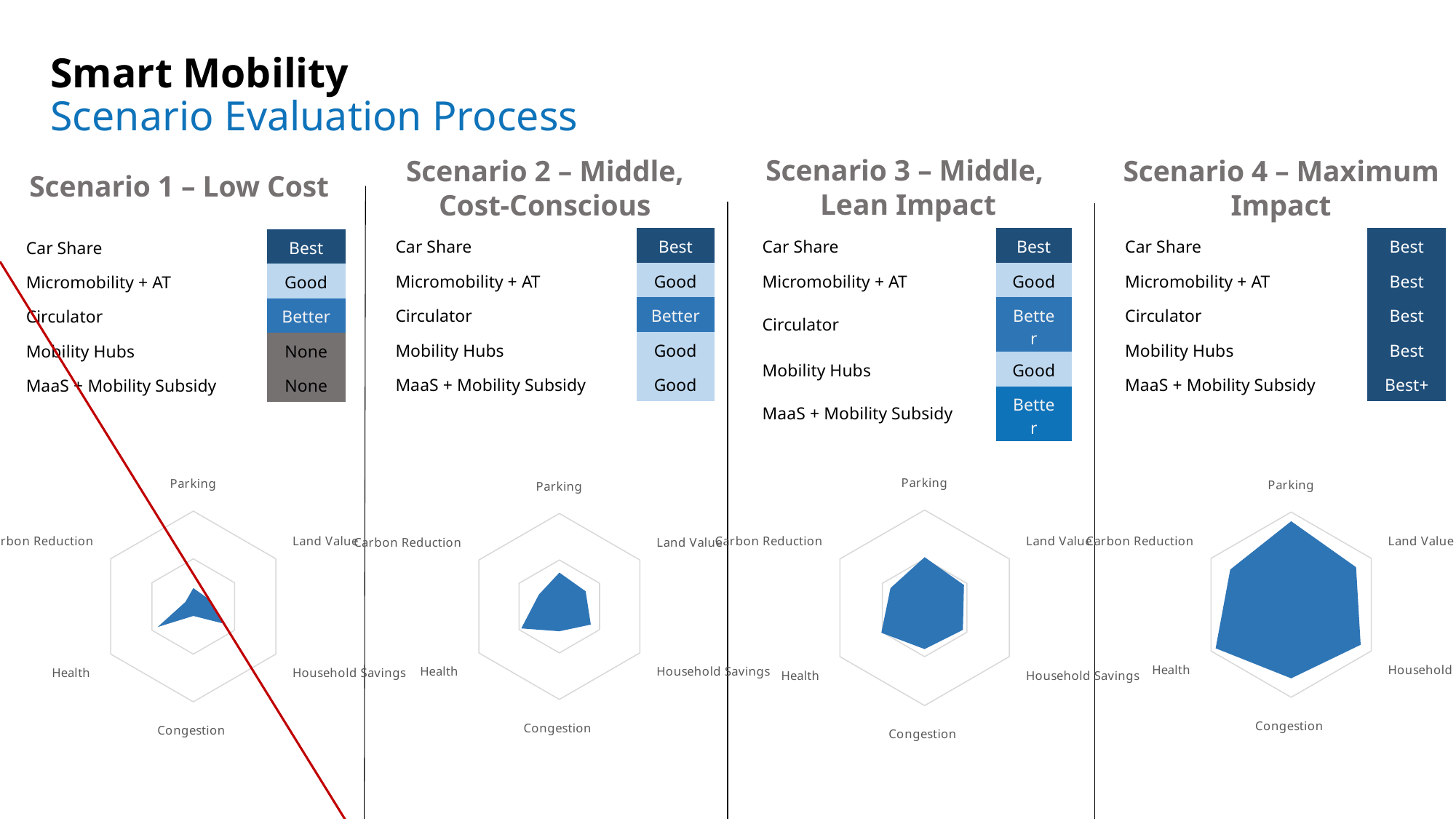
How many categories (axes) does the radar chart under Scenario 4 – Maximum Impact have? 6 Which radar chart covers a larger area, the one under Scenario 2 – Middle, Cost-Conscious or the one under Scenario 3 – Middle, Lean Impact? Scenario 3 – Middle, Lean Impact What kind of chart is shown under Scenario 1 – Low Cost? Radar chart Which scenario's radar chart covers the largest area? Scenario 4 – Maximum Impact Which axis label appears at the top of the radar chart under Scenario 4 – Maximum Impact? Parking How many radar charts are on the slide? 4 Which scenario's radar chart covers the smallest area? Scenario 1 – Low Cost What kind of chart is shown under Scenario 4 – Maximum Impact? Radar chart What are the six axis labels on the radar chart under Scenario 3 – Middle, Lean Impact? Parking, Land Value, Household Savings, Congestion, Health, Carbon Reduction How many categories (axes) does the radar chart under Scenario 2 – Middle, Cost-Conscious have? 6